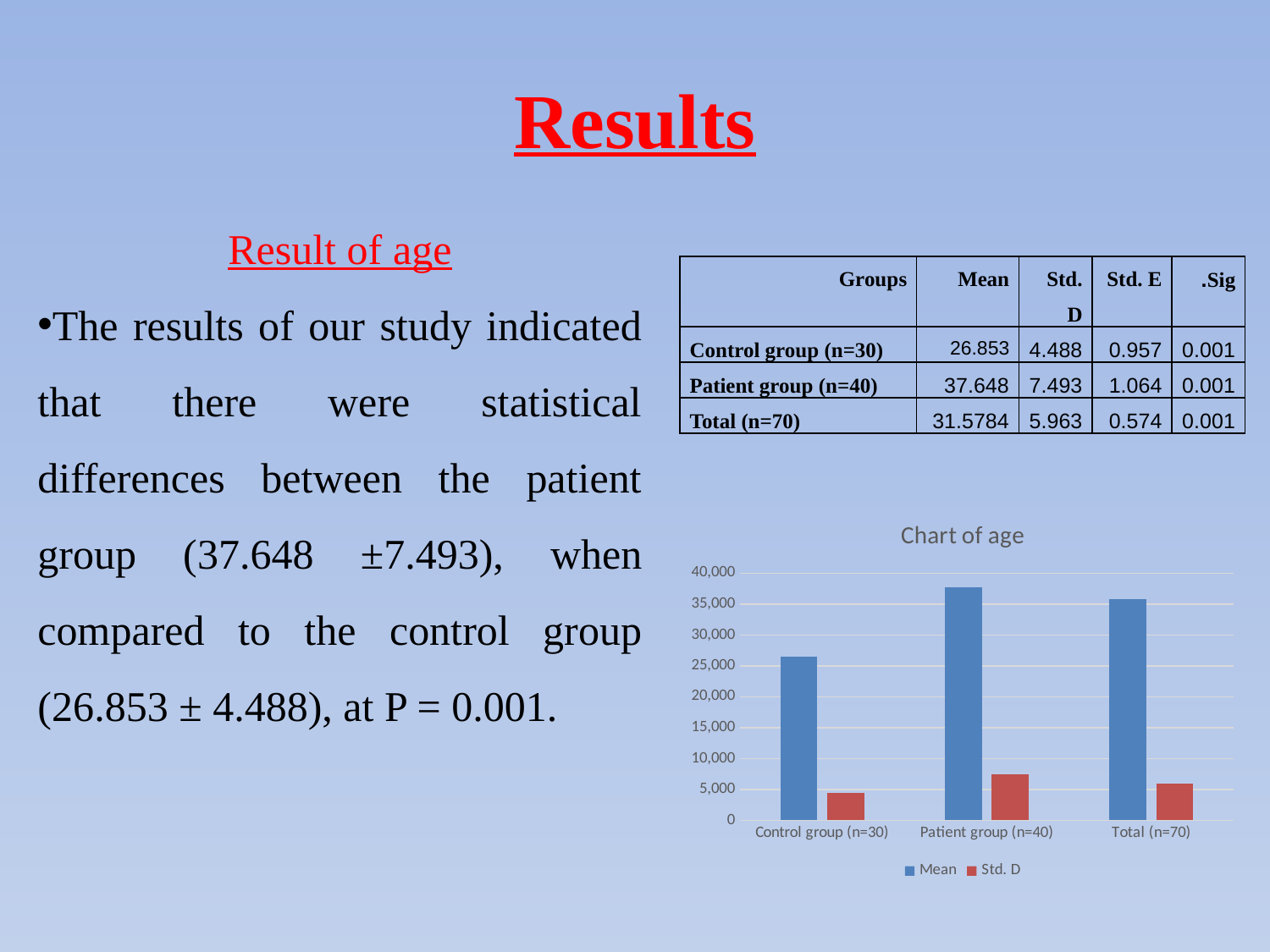
Which group has the highest Std. D bar in the chart? Patient group (n=40) How many groups are plotted along the x axis of the chart? 3 Is the Mean bar for Control group (n=30) greater or less than 30,000? less How many series does the legend of the chart list? 2 What kind of chart is shown on the slide? bar chart Is the Mean bar for Patient group (n=40) greater or less than 35,000? greater Which group has the lowest Mean bar in the chart? Control group (n=30) Which group has the lowest Std. D bar in the chart? Control group (n=30) What is the title of the chart? Chart of age Is the Std. D bar for Patient group (n=40) greater or less than 10,000? less Which group has the highest Mean bar in the chart? Patient group (n=40) Which is larger in the chart: the Mean bar for Total (n=70) or the Mean bar for Control group (n=30)? Total (n=70)